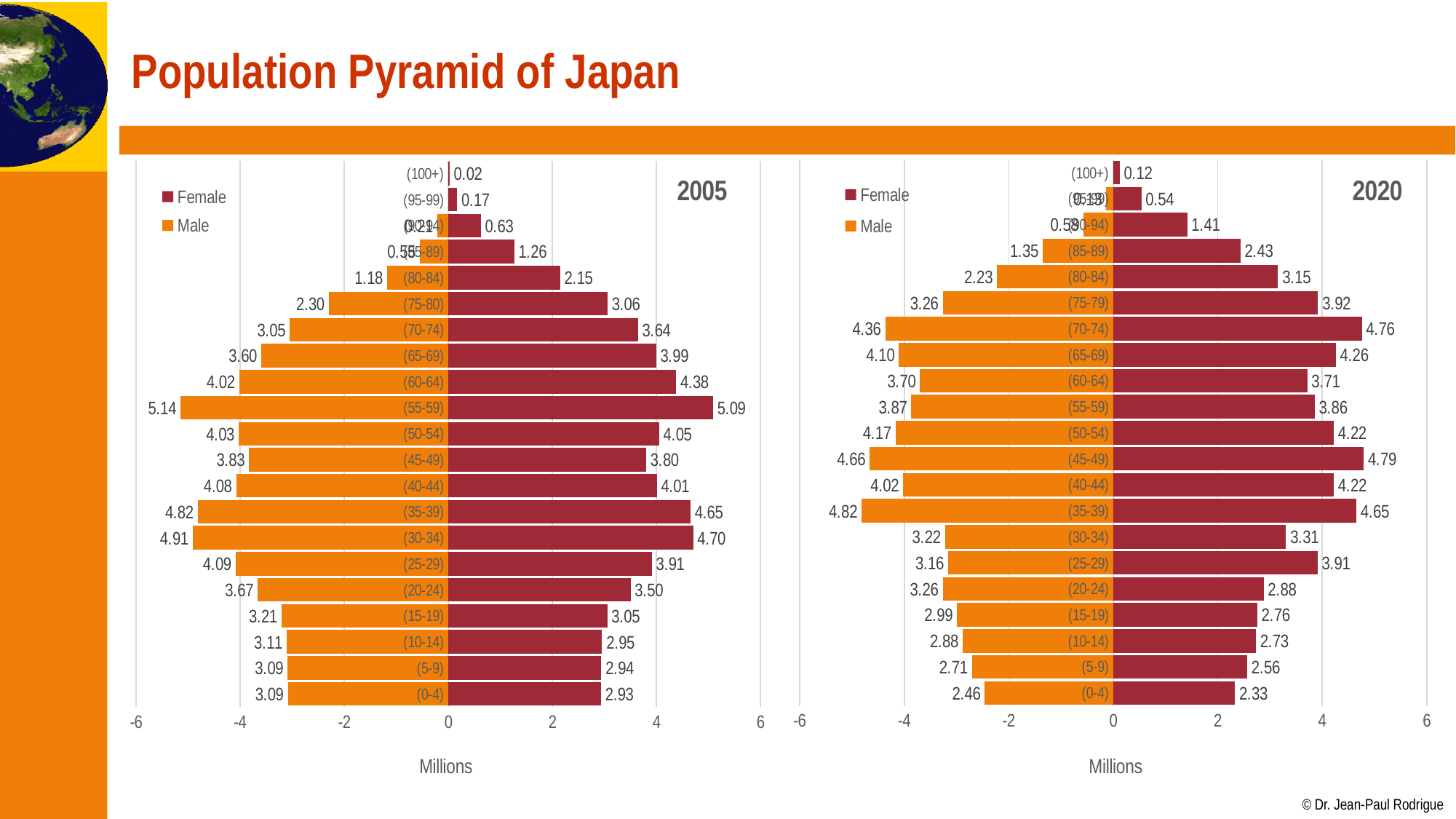
In the 2005 chart, which is larger for the (35-39) age group, the Male value or the Female value? Male How many series does the legend of the 2005 chart list? 2 In the 2005 chart, what is the Male value for the (30-34) age group? 4.91 In the 2020 chart, what is the difference between the Female and Male values for the (70-74) age group? 0.40 In the 2005 chart, what is the Female value for the (55-59) age group? 5.09 In the 2020 chart, what is the Female value for the (70-74) age group? 4.76 What kind of chart is the 2020 chart? Bar chart In the 2020 chart, is the Female value for the (45-49) age group greater or less than 4? greater In the 2020 chart, which age group has the highest Male value? (35-39) In the 2005 chart, which age group has the highest Male value? (55-59) In the 2005 chart, which age group has the lowest Female value? (100+) In the 2020 chart, what is the Male value for the (0-4) age group? 2.46